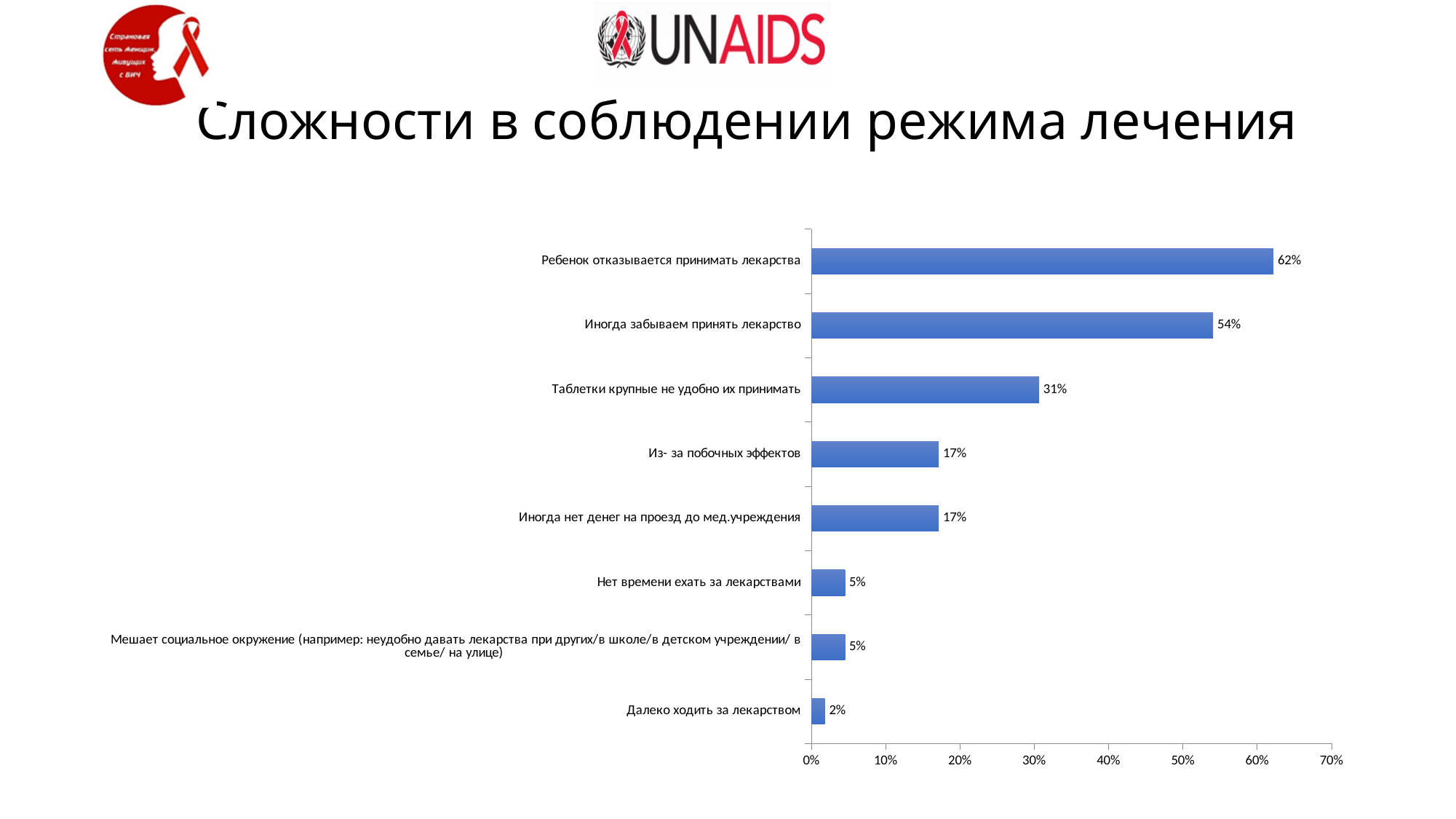
What is the value for "Далеко ходить за лекарством"? 2% What kind of chart is shown on the slide? bar chart What is the value for "Ребенок отказывается принимать лекарства"? 62% Which category has the highest value? Ребенок отказывается принимать лекарства Is the value for "Иногда забываем принять лекарство" greater or less than 50%? greater What is the difference between "Ребенок отказывается принимать лекарства" and "Иногда забываем принять лекарство"? 8% What is the title of the slide? Сложности в соблюдении режима лечения How many categories are shown in the chart? 8 Which category has the lowest value? Далеко ходить за лекарством Which is larger: "Иногда забываем принять лекарство" or "Таблетки крупные не удобно их принимать"? Иногда забываем принять лекарство What is the value for "Таблетки крупные не удобно их принимать"? 31% What is the value for "Иногда нет денег на проезд до мед.учреждения"? 17%